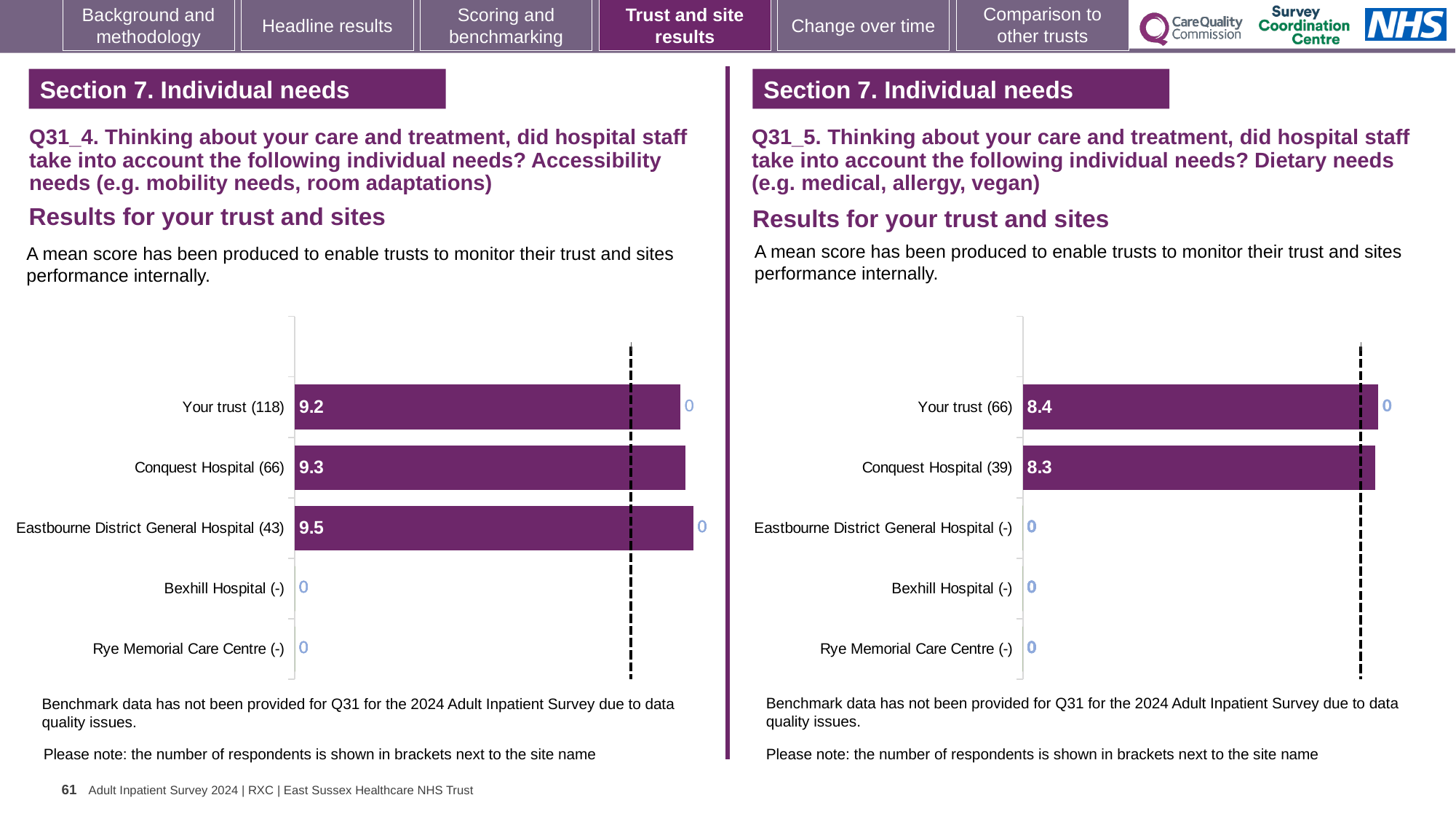
In the Q31_4 chart (Accessibility needs) on the left, how many respondents are shown for Your trust? 118 In the Q31_5 chart (Dietary needs) on the right, which has the higher mean score, Your trust or Conquest Hospital? Your trust In the Q31_4 chart (Accessibility needs) on the left, which site has the highest mean score? Eastbourne District General Hospital In the Q31_4 chart (Accessibility needs) on the left, what is the difference between the mean scores for Eastbourne District General Hospital and Your trust? 0.3 How many categories (sites) are listed on the y axis of the Q31_5 chart on the right? 5 In the Q31_5 chart (Dietary needs) on the right, what is the difference between the mean scores for Your trust and Conquest Hospital? 0.1 What type of chart is used for the Q31_4 results on the left? Bar chart In the Q31_5 chart (Dietary needs) on the right, what is the mean score for Your trust? 8.4 In the Q31_4 chart (Accessibility needs) on the left, what is the mean score for Conquest Hospital? 9.3 In the Q31_5 chart (Dietary needs) on the right, what is the mean score for Conquest Hospital? 8.3 In the Q31_4 chart (Accessibility needs) on the left, what is the mean score for Your trust? 9.2 In the Q31_5 chart (Dietary needs) on the right, how many respondents are shown for Conquest Hospital? 39